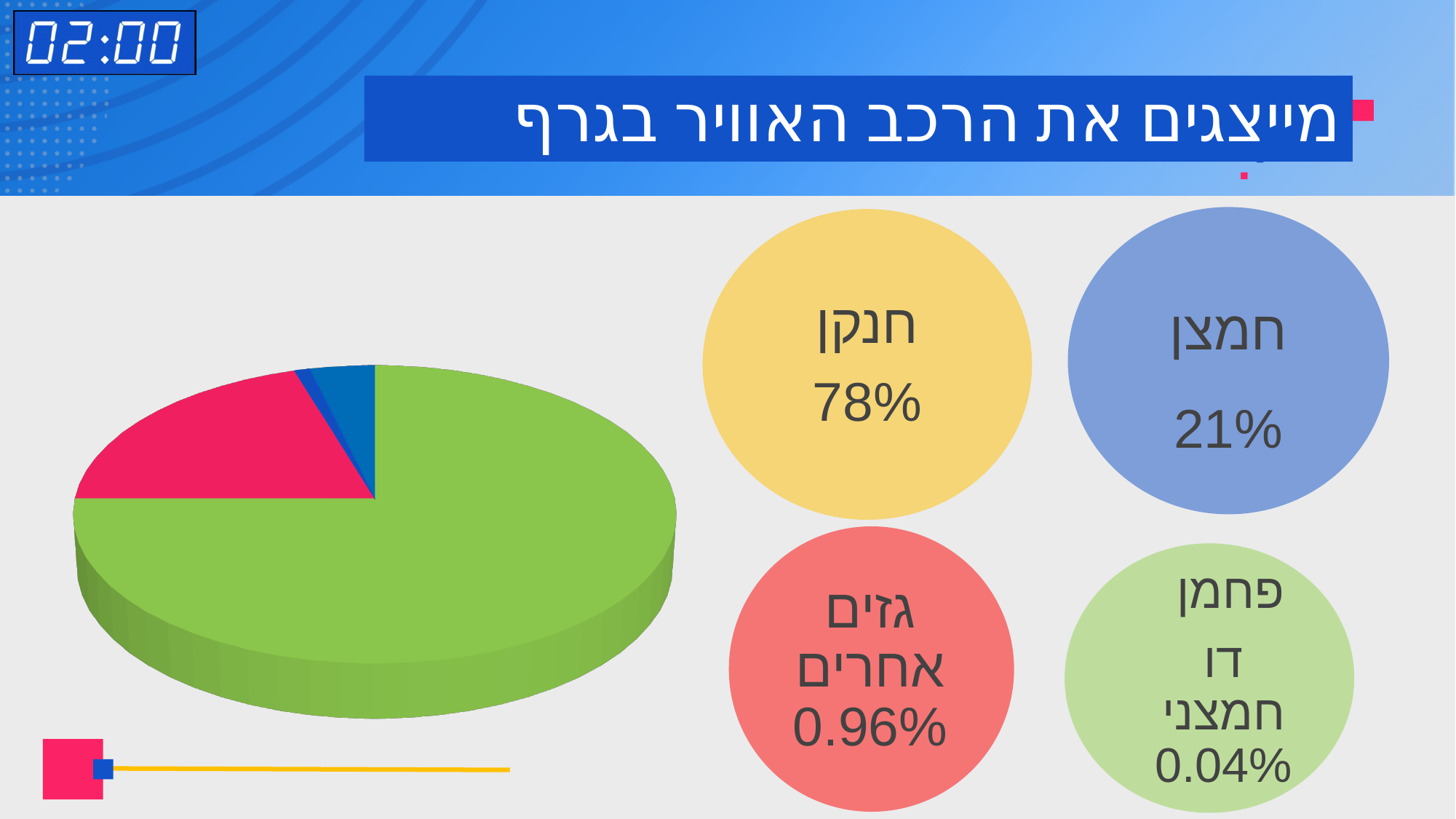
What is the title of the slide? מייצגים את הרכב האוויר בגרף What percentage is shown for גזים אחרים on the slide? 0.96% What percentage is shown for פחמן דו חמצני on the slide? 0.04% What percentage is shown for חמצן on the slide? 21% Which component has the largest share according to the slide? חנקן Which is larger, the share of גזים אחרים or the share of פחמן דו חמצני? גזים אחרים How many slices does the pie chart have? 4 What colour is the largest slice of the pie chart? green What percentage is shown for חנקן on the slide? 78% What kind of chart is shown on the left of the slide? pie chart Which component has the smallest share according to the slide? פחמן דו חמצני What is the difference in percentage points between חנקן and חמצן? 57